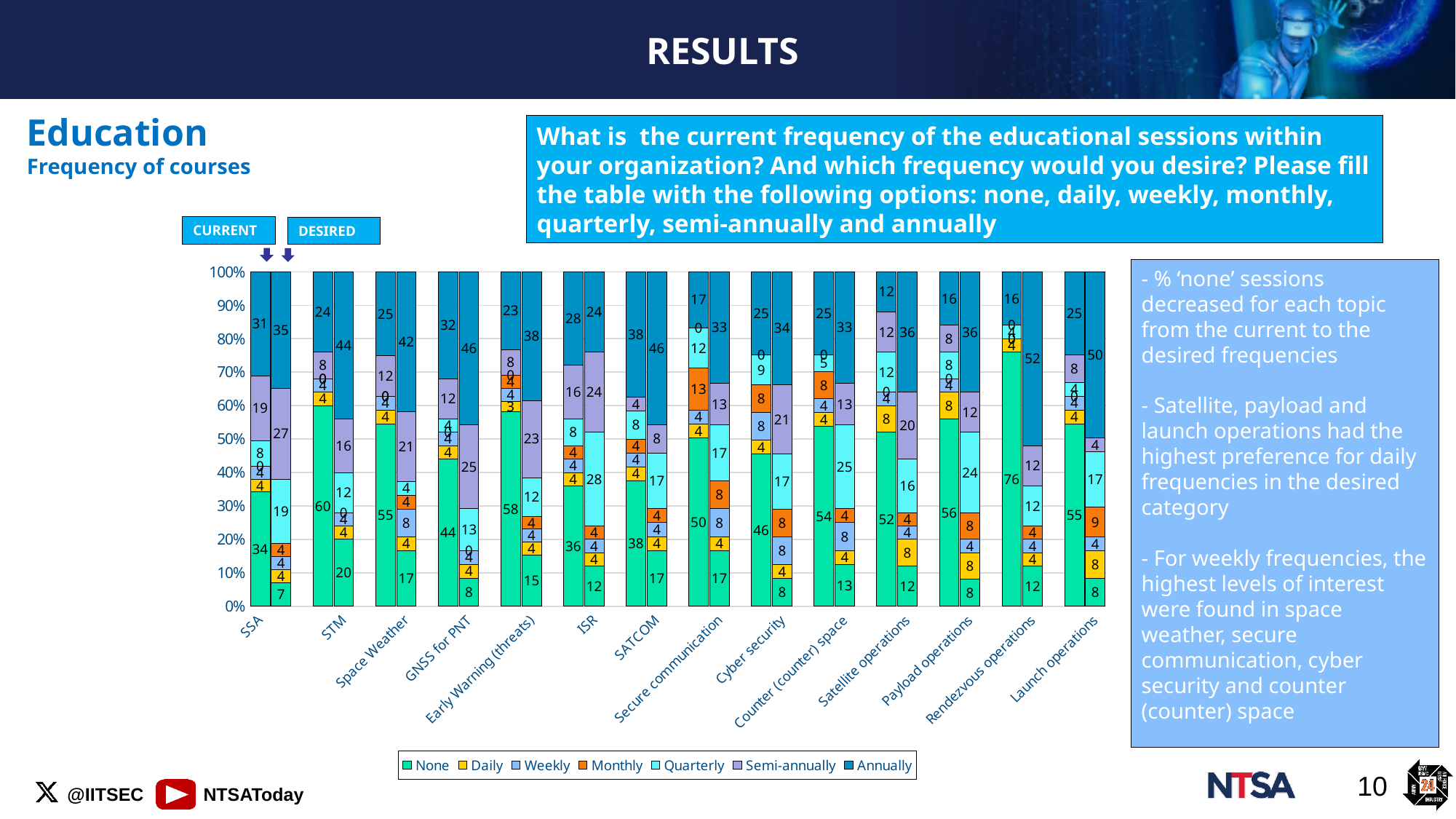
What is the 'None' value in the CURRENT bar for Rendezvous operations? 76 Which topic has the lowest 'None' value in its DESIRED bar? SSA What is the 'Annually' value in the DESIRED bar for Rendezvous operations? 52 Which topic has the highest 'None' value in its CURRENT bar? Rendezvous operations What is the 'None' value in the DESIRED bar for SSA? 7 By how much does the 'None' value for Rendezvous operations drop from the CURRENT bar (76) to the DESIRED bar (12)? 64 Which legend entry is shown in green? None What is the 'Quarterly' value in the DESIRED bar for ISR? 28 How many series does the chart legend list? 7 Which has the larger 'None' value in the CURRENT bar: STM or Space Weather? STM How many topics (categories) are shown along the x axis of the chart? 14 What type of chart is shown on the slide? Stacked bar chart